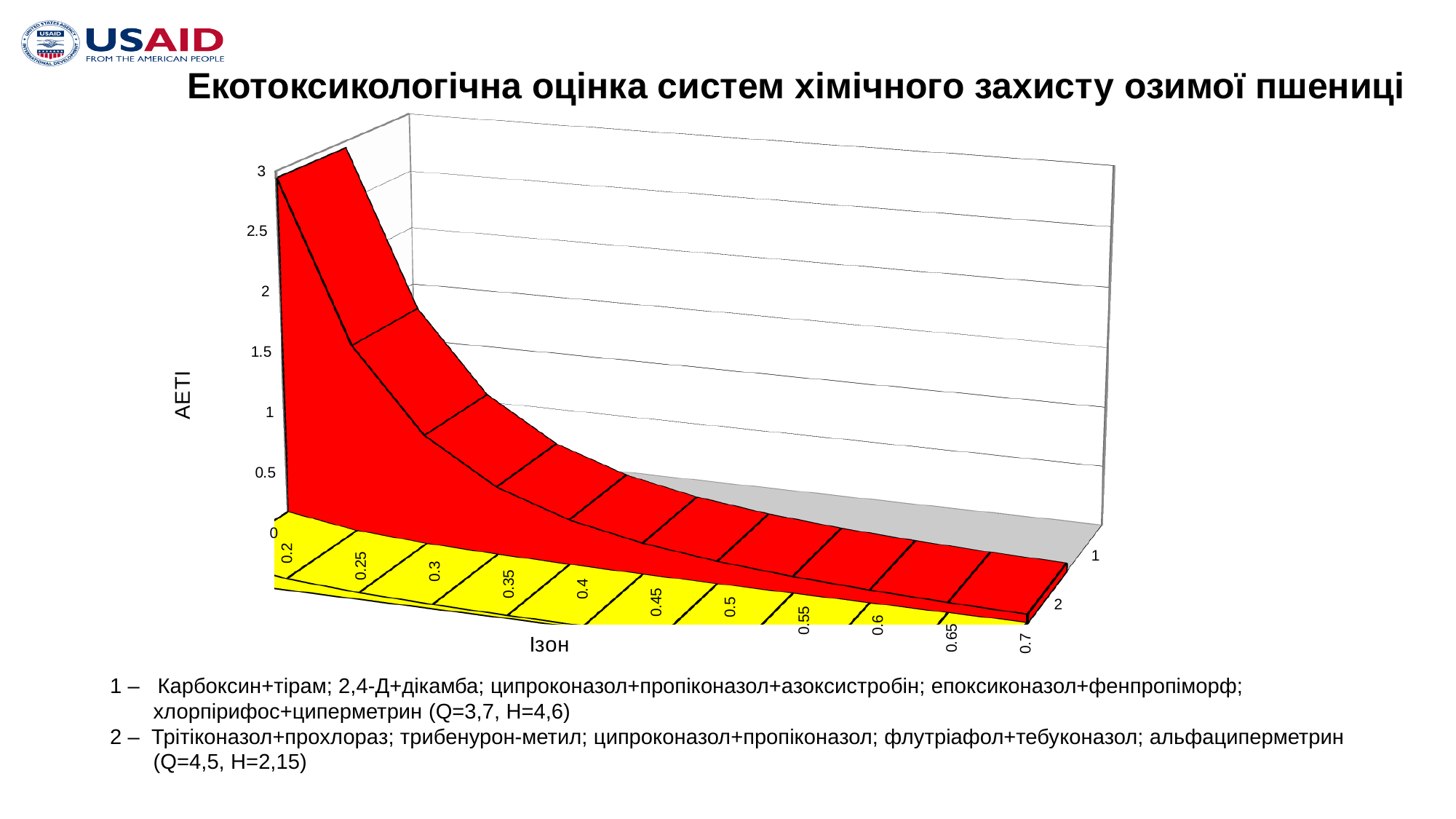
What is the label of the vertical axis? AETI Which has the larger AETI value: Ізон 0.25 or Ізон 0.6? 0.25 What is the highest tick value shown on the AETI axis? 3 At which Ізон value is AETI highest? 0.2 Do the AETI values rise or fall as Ізон increases from 0.2 to 0.7? fall How many series (depth-axis categories) does the chart plot? 2 How many Ізон values are marked along the x axis? 11 Is the AETI value at Ізон 0.2 greater or less than 2? greater Is the AETI value at Ізон 0.7 greater or less than 0.5? less At which Ізон value is AETI lowest? 0.7 What is the title of the chart? Екотоксикологічна оцінка систем хімічного захисту озимої пшениці What kind of chart is shown on the slide? 3D area chart